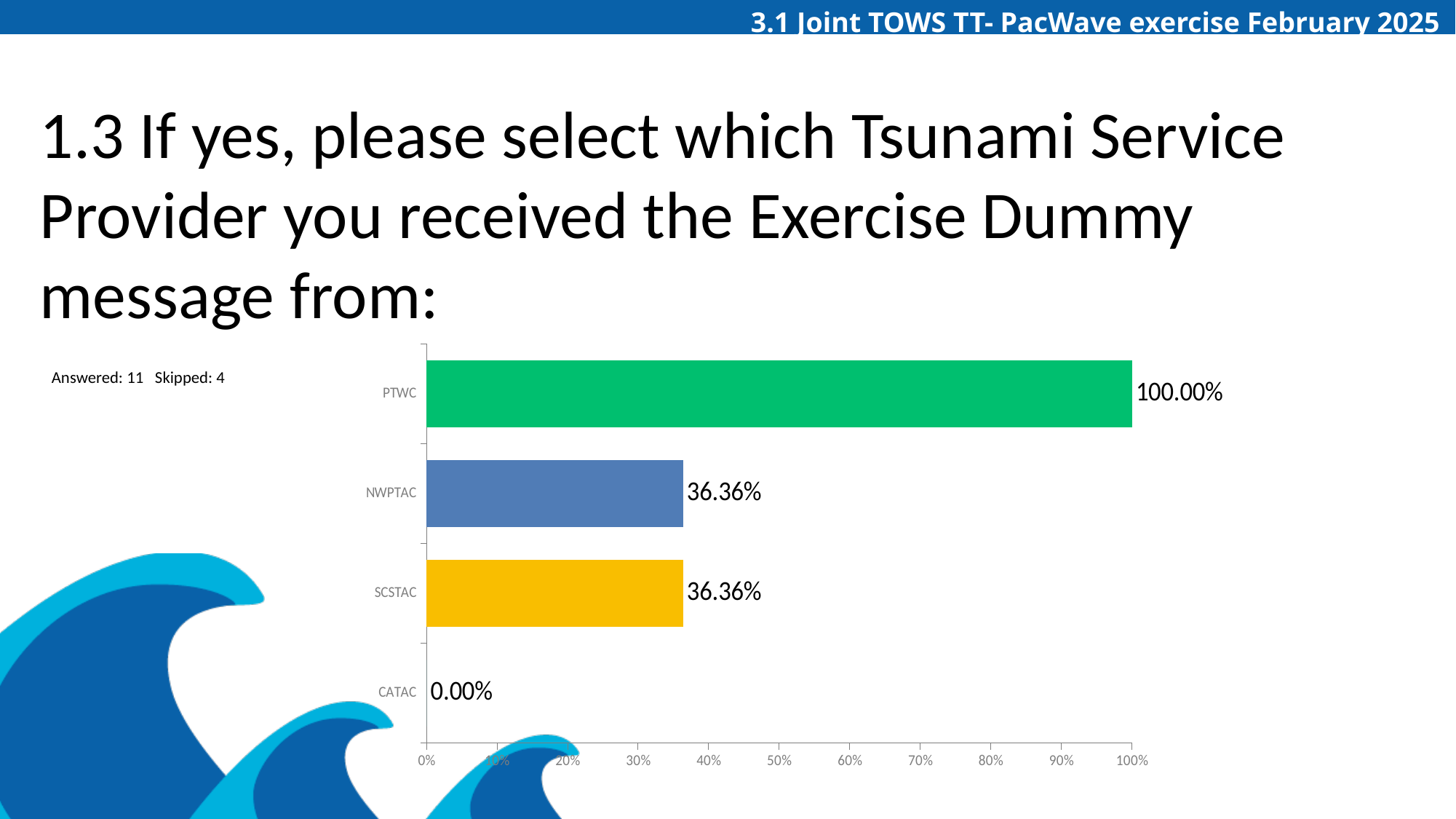
What kind of chart is shown on the slide? bar chart What is the value for PTWC? 100.00% Is the value for NWPTAC greater or less than 40%? less What is the value for NWPTAC? 36.36% What colour is the bar for SCSTAC? yellow Which category has the lowest value? CATAC Which category has the highest value? PTWC Which is larger, the value for PTWC or the value for SCSTAC? PTWC What is the value for CATAC? 0.00% How many categories are shown in the chart? 4 What is the difference between the values for PTWC and NWPTAC? 63.64% What is the value for SCSTAC? 36.36%